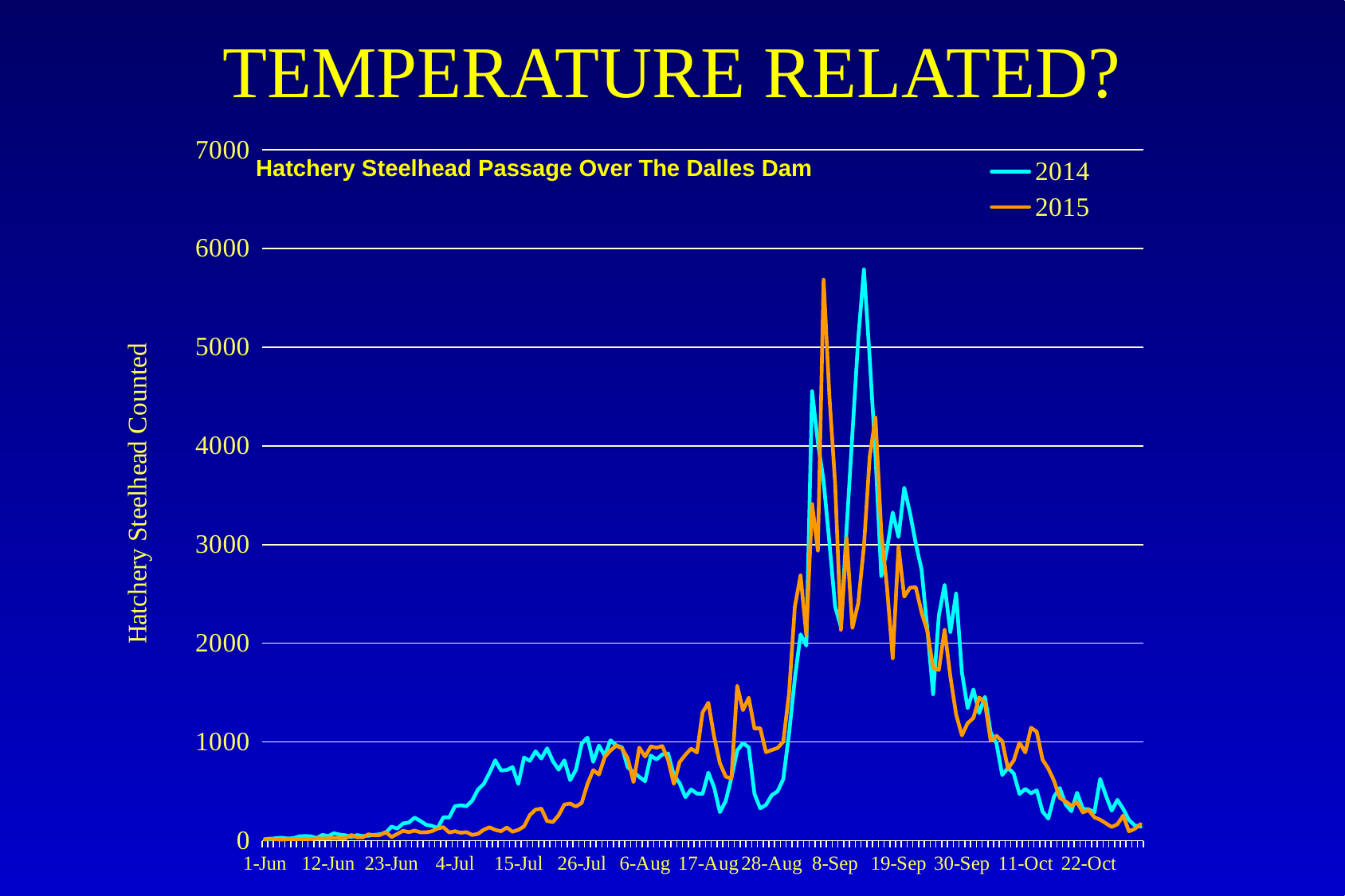
Is the peak value of the 2014 series greater or less than 5000? greater What is the label on the vertical axis of the chart? Hatchery Steelhead Counted Around 4-Jul, which series has the higher value, 2014 or 2015? 2014 Around 17-Aug, which series has the higher value, 2014 or 2015? 2015 Do the values of the 2015 series rise or fall between 30-Sep and 22-Oct? fall Is the peak value of the 2015 series greater or less than 5000? greater Is the highest value reached by either series greater or less than 6000? less What is the title of the chart? Hatchery Steelhead Passage Over The Dalles Dam What kind of chart is shown on the slide? Line chart How many series does the legend list? 2 Around 19-Sep, which series has the higher value, 2014 or 2015? 2014